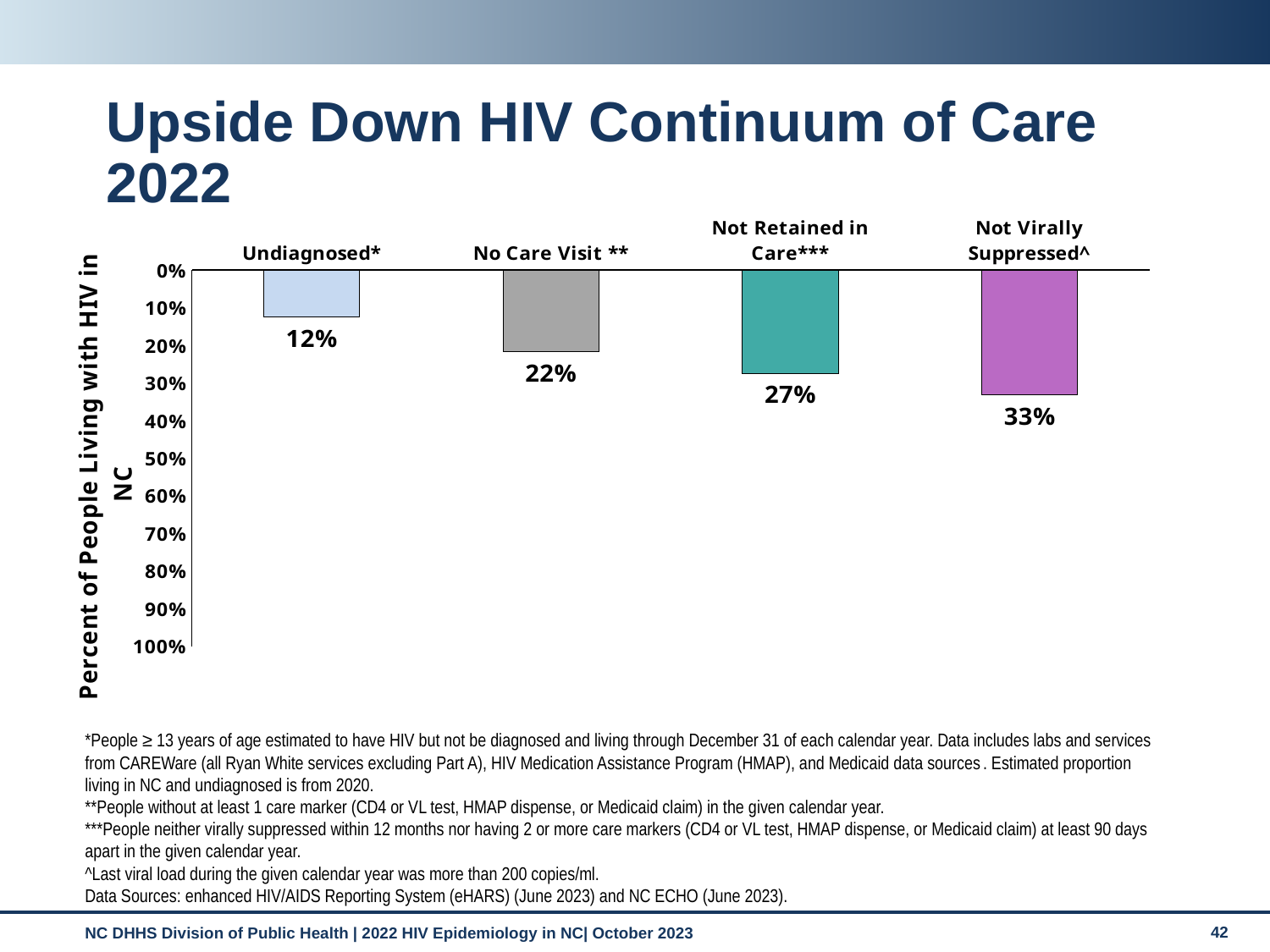
Which is larger, the value for No Care Visit ** or the value for Not Retained in Care***? Not Retained in Care*** What is the value for Not Retained in Care***? 27% What kind of chart is shown on the slide? Bar chart Which category has the lowest value? Undiagnosed* Which category has the highest value? Not Virally Suppressed^ Do the values rise or fall from left to right across the categories? Rise What is the value for Not Virally Suppressed^? 33% What is the value for Undiagnosed*? 12% How many categories are shown in the chart? 4 What is the difference between the values for Not Virally Suppressed^ and Undiagnosed*? 21% What is the difference between the values for Not Retained in Care*** and No Care Visit **? 5% What is the value for No Care Visit **? 22%